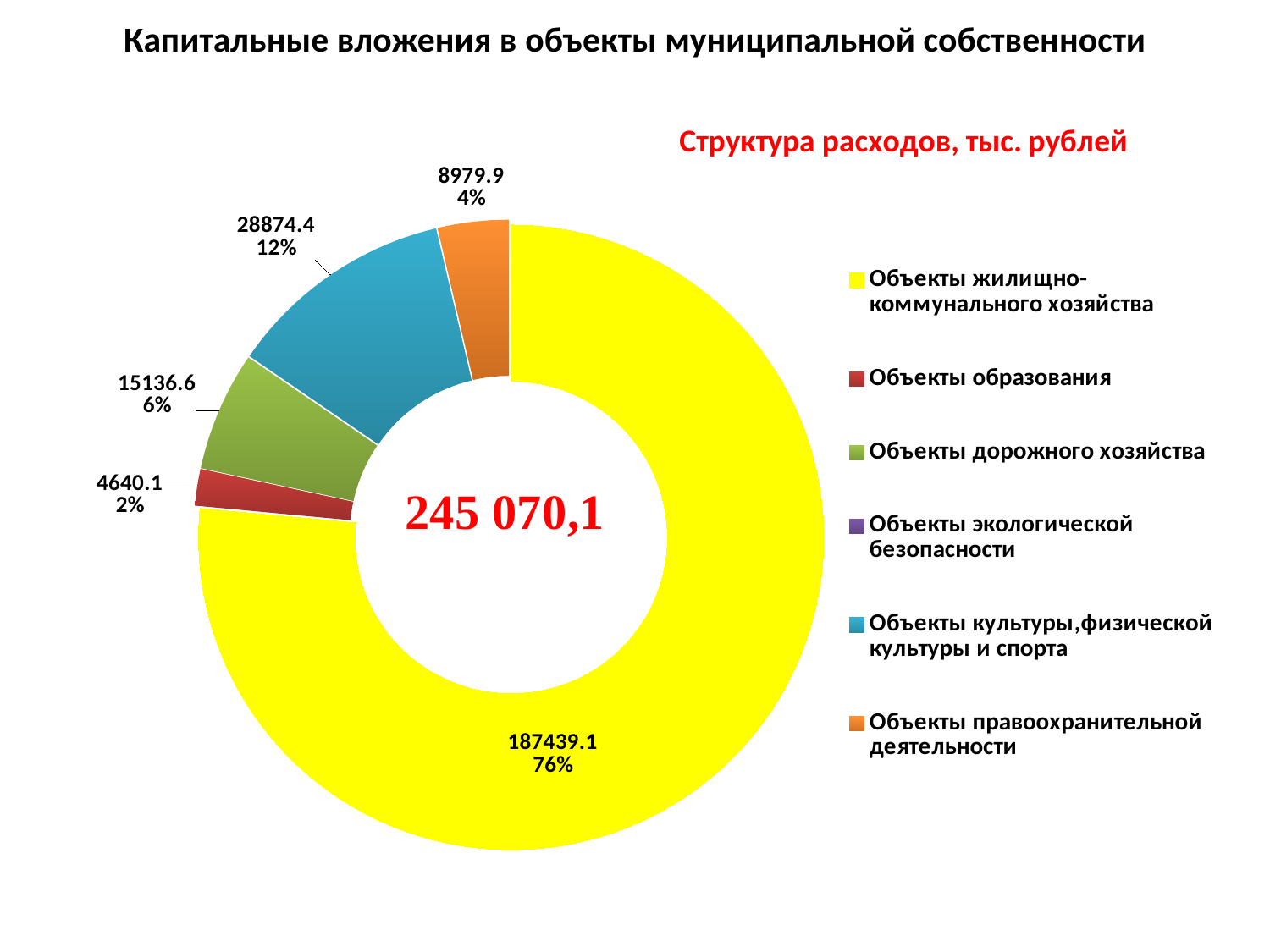
What is the difference between the values for Объекты культуры, физической культуры и спорта and Объекты правоохранительной деятельности? 19894.5 What share of the chart does Объекты образования take? 2% What type of chart is shown on the slide? Doughnut (pie) chart What is the value for Объекты дорожного хозяйства? 15136.6 Which is larger: Объекты дорожного хозяйства or Объекты образования? Объекты дорожного хозяйства What is the value for Объекты культуры, физической культуры и спорта? 28874.4 Which category has the largest value? Объекты жилищно-коммунального хозяйства What share of the chart does Объекты жилищно-коммунального хозяйства take? 76% What total is shown in the centre of the chart? 245 070,1 What is the value for Объекты правоохранительной деятельности? 8979.9 What is the value for Объекты жилищно-коммунального хозяйства? 187439.1 How many entries does the legend list? 6